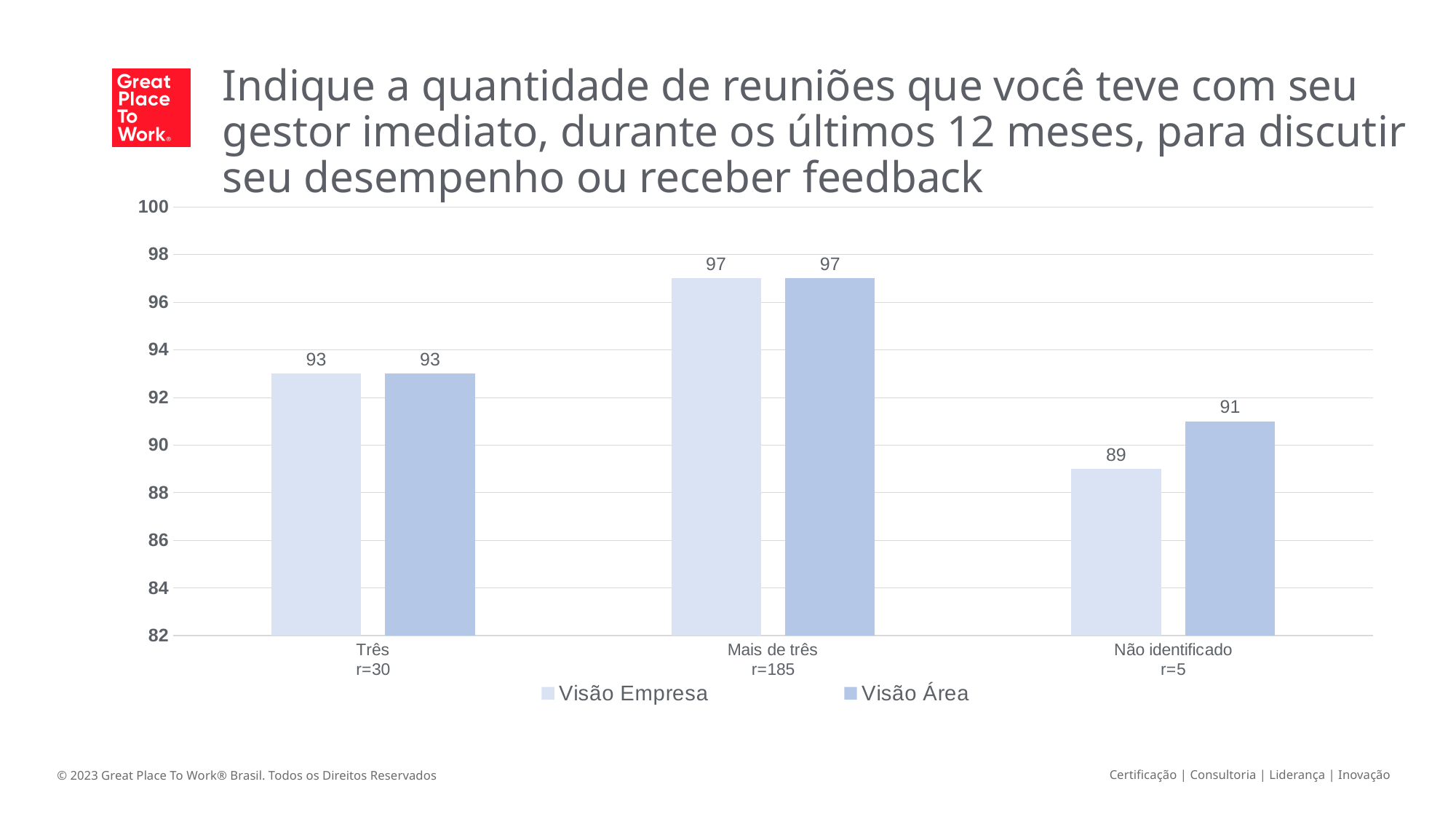
What is the value of Visão Empresa for the category Mais de três? 97 How many categories are shown on the x axis? 3 What is the difference between the Visão Empresa values for Mais de três and Três? 4 What is the value of Visão Empresa for the category Três? 93 What is the value of Visão Área for the category Não identificado? 91 What is the number of respondents (r) shown for the category Mais de três? r=185 What kind of chart is shown on the slide? Bar chart How many series does the legend list? 2 Which is larger for Não identificado: Visão Empresa or Visão Área? Visão Área Which category has the highest value for Visão Área? Mais de três What is the difference between Visão Área and Visão Empresa for Não identificado? 2 Which category has the lowest value for Visão Empresa? Não identificado